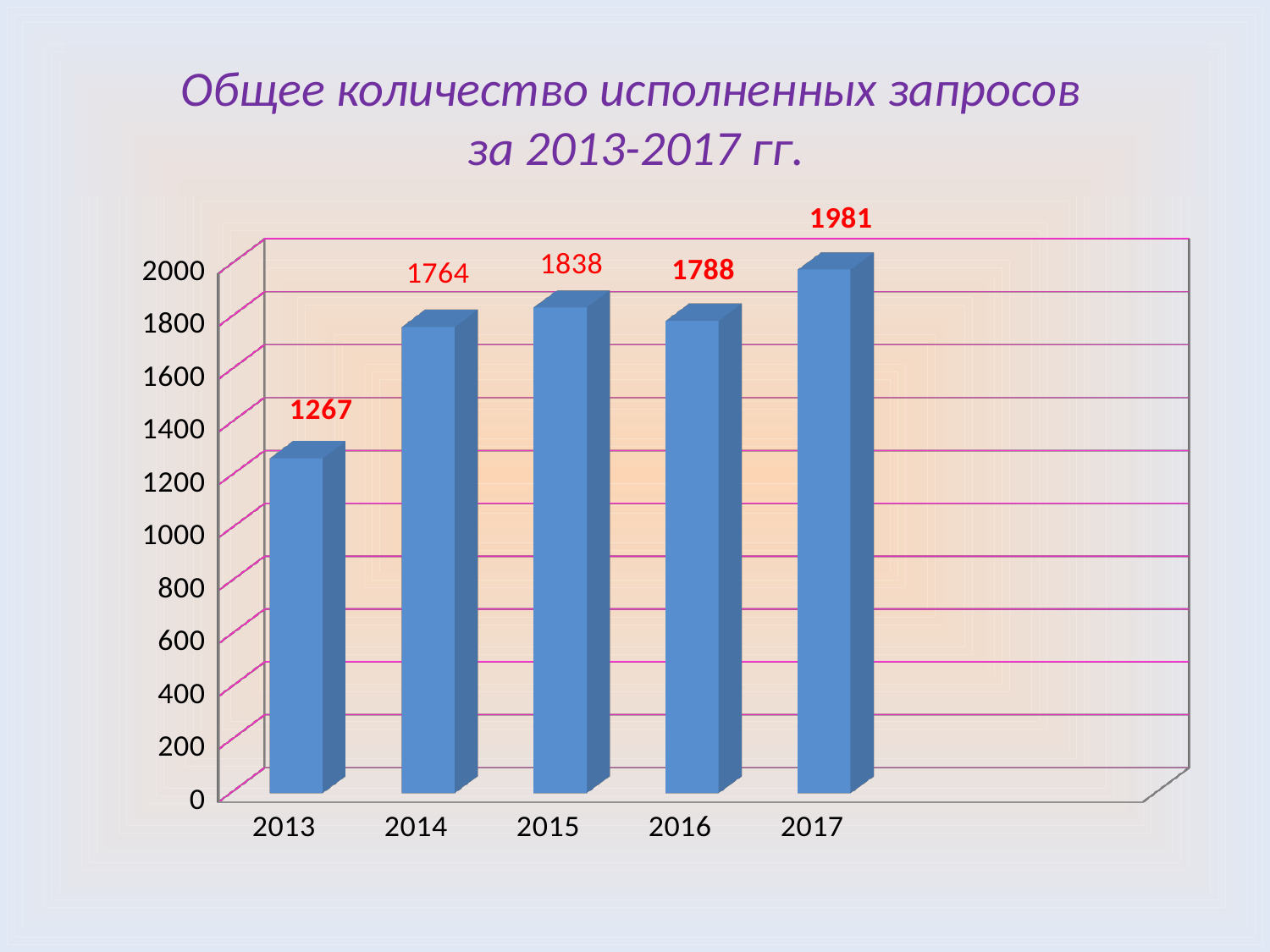
Which is larger, the value for 2014 or the value for 2016? 2016 Which year has the lowest value? 2013 What is the difference between the values for 2015 and 2016? 50 Is the value for 2013 greater or less than 1400? less Which year has the highest value? 2017 What is the value for 2013? 1267 What is the value for 2015? 1838 What is the difference between the values for 2017 and 2013? 714 What kind of chart is shown on the slide? bar chart What is the value for 2017? 1981 How many years are shown on the chart? 5 What is the title of the chart? Общее количество исполненных запросов за 2013-2017 гг.